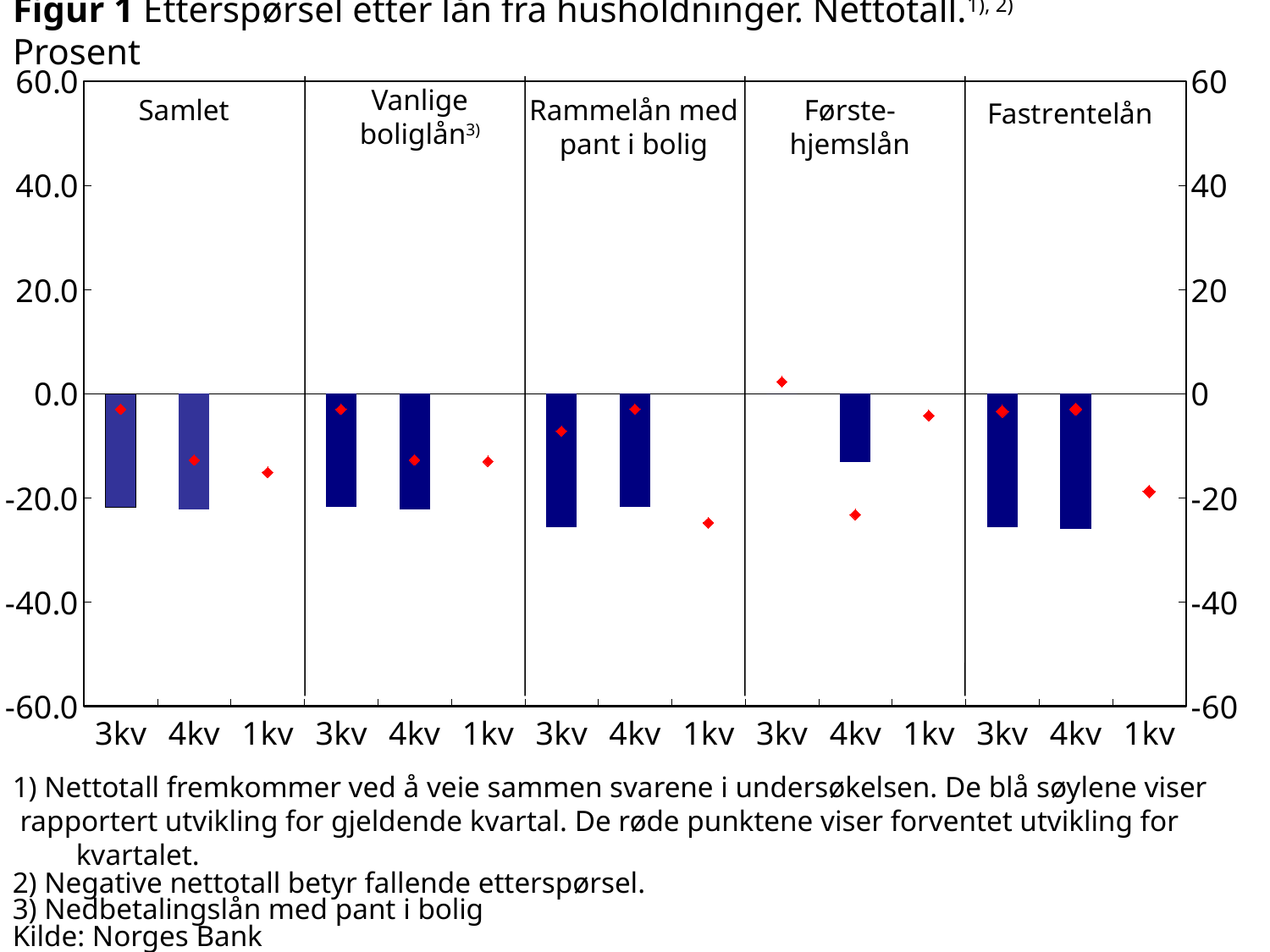
What kind of chart is shown on the slide? bar chart Is the red point for 3kv in the Førstehjemslån panel greater or less than 0? greater Is the bar value for 4kv in the Førstehjemslån panel greater or less than -20? greater According to the footnote, what do the red points in the chart show? Forventet utvikling for kvartalet Which is higher: the 4kv bar in the Førstehjemslån panel or the 4kv bar in the Fastrentelån panel? Førstehjemslån Is the bar value for 3kv in the Rammelån med pant i bolig panel greater or less than -20? less How many loan categories (panels) are shown in the chart? 5 What is the source given for the chart? Norges Bank How many quarters are shown on the x axis within each panel? 3 In the Samlet panel, do the red points rise or fall from 3kv to 1kv? fall